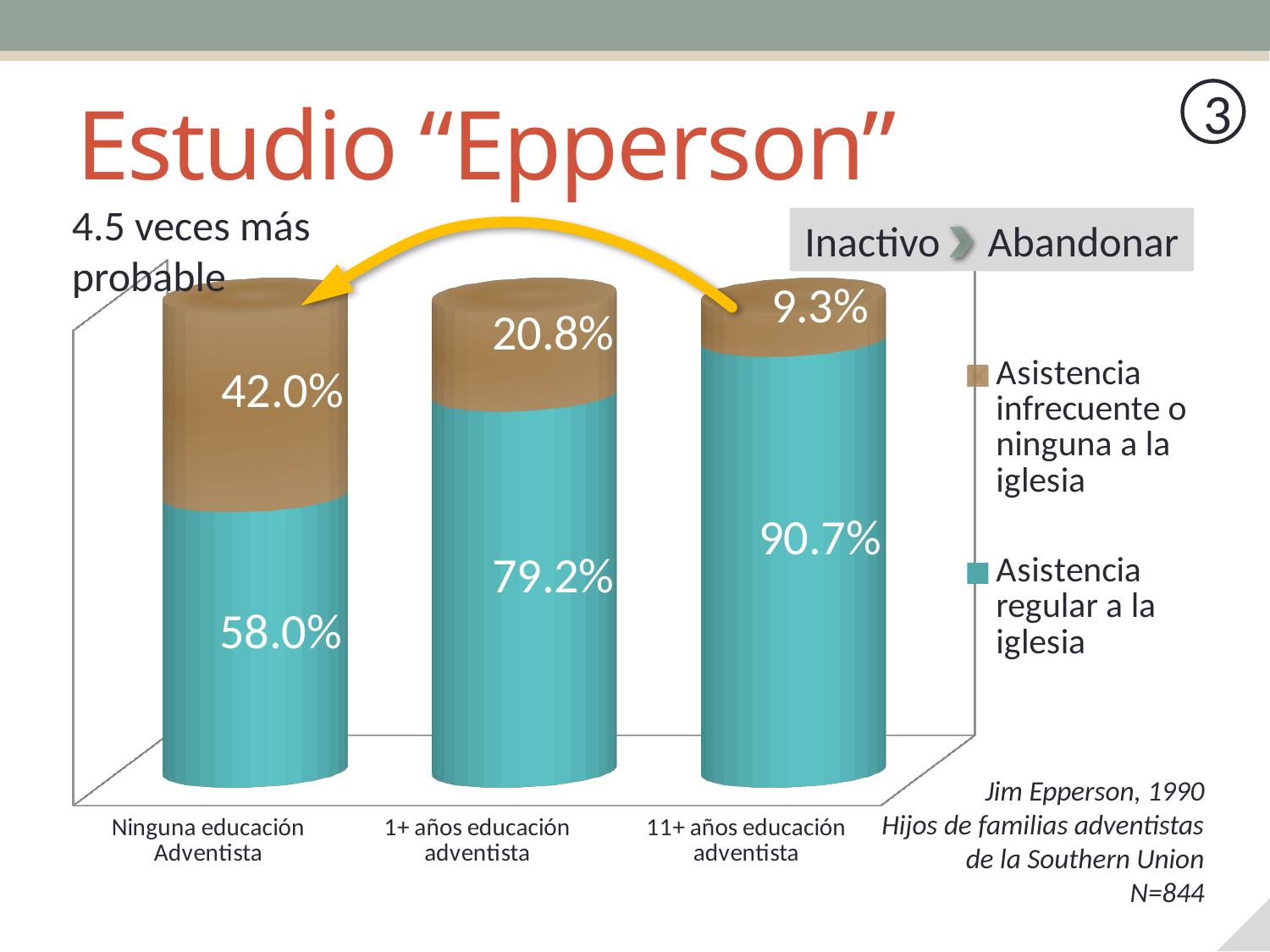
What is the value for "Asistencia infrecuente o ninguna a la iglesia" in the "1+ años educación adventista" category? 20.8% Does the value for "Asistencia regular a la iglesia" rise or fall from left to right across the categories? Rise What is the value for "Asistencia regular a la iglesia" in the "11+ años educación adventista" category? 90.7% What is the difference between the "Asistencia infrecuente o ninguna a la iglesia" values for "Ninguna educación Adventista" and "11+ años educación adventista"? 32.7 percentage points What is the value for "Asistencia regular a la iglesia" in the "Ninguna educación Adventista" category? 58.0% Which category has the lowest value for "Asistencia regular a la iglesia"? Ninguna educación Adventista Which category has the highest value for "Asistencia infrecuente o ninguna a la iglesia"? Ninguna educación Adventista What is the value for "Asistencia infrecuente o ninguna a la iglesia" in the "11+ años educación adventista" category? 9.3% Which is larger: "Asistencia regular a la iglesia" for "1+ años educación adventista" or for "Ninguna educación Adventista"? 1+ años educación adventista How many categories are shown on the x axis of the chart? 3 What kind of chart is shown on the slide? Stacked bar chart How many series does the chart legend list? 2